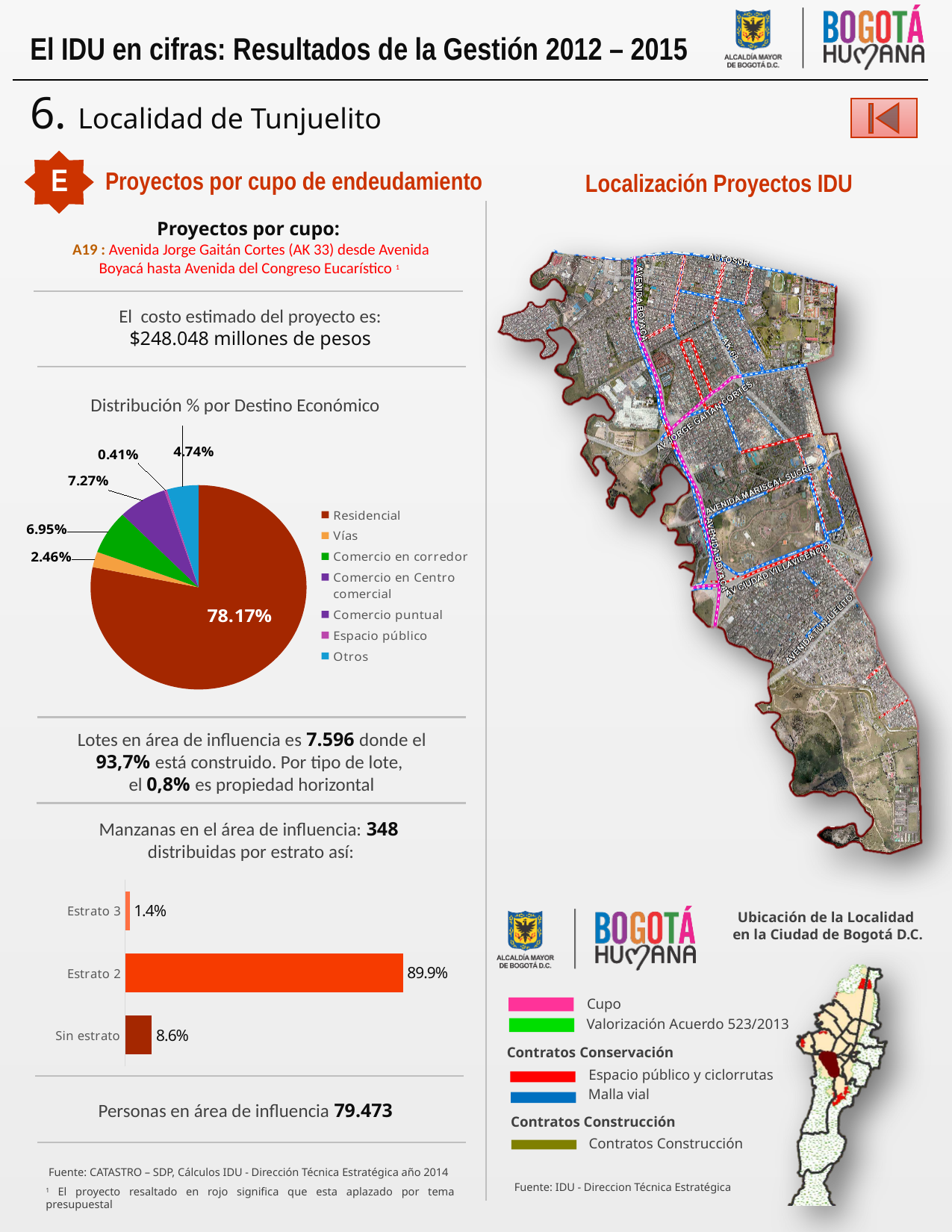
In the 'Distribución % por Destino Económico' pie chart, what is the value for Otros? 4.74% What type of chart is 'Distribución % por Destino Económico'? Pie chart In the 'Distribución % por Destino Económico' pie chart, how many entries does the legend list? 7 In the 'Distribución % por Destino Económico' pie chart, what share does Residencial have? 78.17% In the 'Distribución % por Destino Económico' pie chart, which is larger: Comercio en corredor or Vías? Comercio en corredor In the bar chart of manzanas by estrato, what is the value for Sin estrato? 8.6% In the bar chart of manzanas by estrato, which category has the lowest value? Estrato 3 In the 'Distribución % por Destino Económico' pie chart, what is the value for Vías? 2.46% In the bar chart of manzanas by estrato, how many categories are shown? 3 In the bar chart of manzanas by estrato, what is the value for Estrato 2? 89.9% In the 'Distribución % por Destino Económico' pie chart, what is the value for Comercio en corredor? 6.95% In the 'Distribución % por Destino Económico' pie chart, which category has the largest share? Residencial